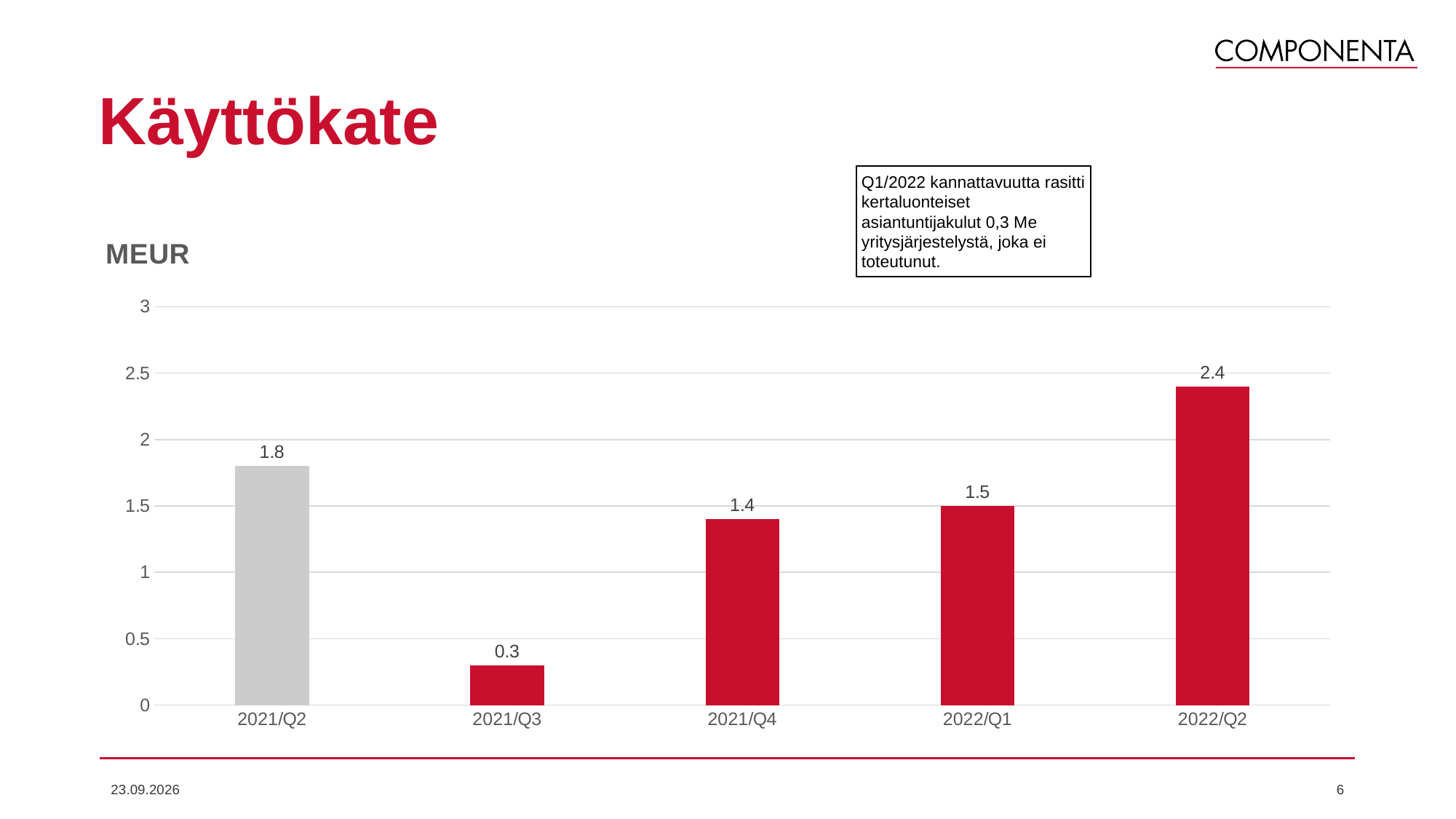
What is the value for 2022/Q2? 2.4 What is the value for 2021/Q3? 0.3 Is the value for 2022/Q2 greater or less than 2? greater What is the value for 2021/Q2? 1.8 What is the difference between the values for 2022/Q2 and 2022/Q1? 0.9 What is the difference between the values for 2021/Q2 and 2021/Q3? 1.5 Which is larger, the value for 2021/Q4 or the value for 2022/Q1? 2022/Q1 Which quarter has the lowest value? 2021/Q3 How many quarters are shown on the x axis? 5 What unit is stated above the chart? MEUR Which quarter has the highest value? 2022/Q2 What kind of chart is shown on the slide? bar chart